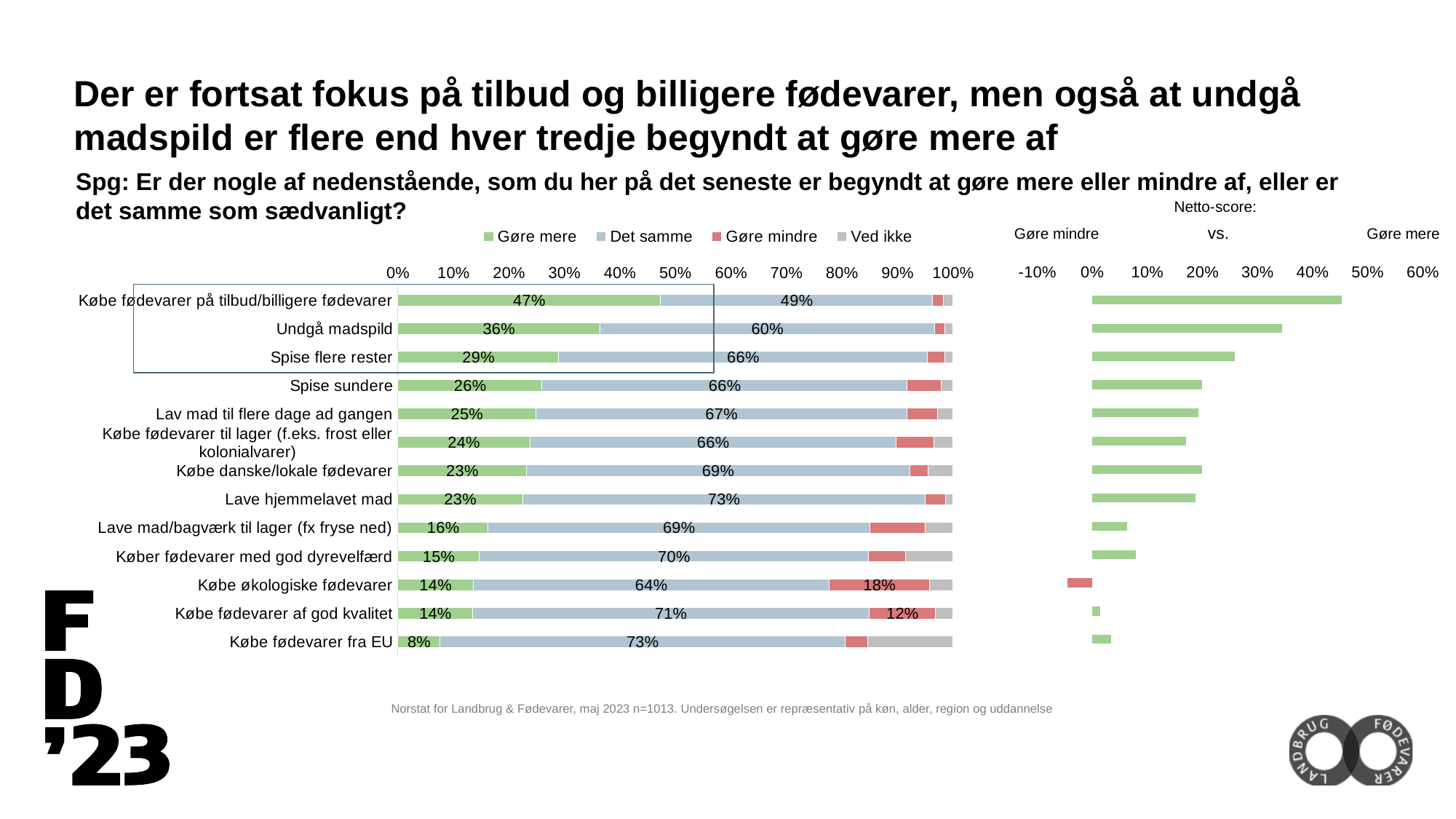
In the stacked bar chart on the left, which category has the lowest 'Gøre mere' share? Købe fødevarer fra EU In the stacked bar chart on the left, what is the difference between the 'Gøre mere' shares for 'Undgå madspild' and 'Spise flere rester'? 7% What kind of chart is the 'Netto-score' chart on the right? Bar chart How many series does the legend of the stacked bar chart on the left list? 4 In the 'Netto-score' chart on the right, is the value for 'Købe fødevarer på tilbud/billigere fødevarer' greater or less than 40%? greater In the stacked bar chart on the left, which category has the highest 'Gøre mere' share? Købe fødevarer på tilbud/billigere fødevarer In the 'Netto-score' chart on the right, is the value for 'Købe økologiske fødevarer' greater or less than 0%? less In the stacked bar chart on the left, what percentage answered 'Det samme' for 'Undgå madspild'? 60% In the stacked bar chart on the left, what percentage answered 'Gøre mere' for 'Købe fødevarer på tilbud/billigere fødevarer'? 47% How many categories are shown in the stacked bar chart on the left? 13 In the stacked bar chart on the left, what percentage answered 'Gøre mindre' for 'Købe økologiske fødevarer'? 18% In the stacked bar chart on the left, which has a larger 'Det samme' share: 'Lave hjemmelavet mad' or 'Købe danske/lokale fødevarer'? Lave hjemmelavet mad